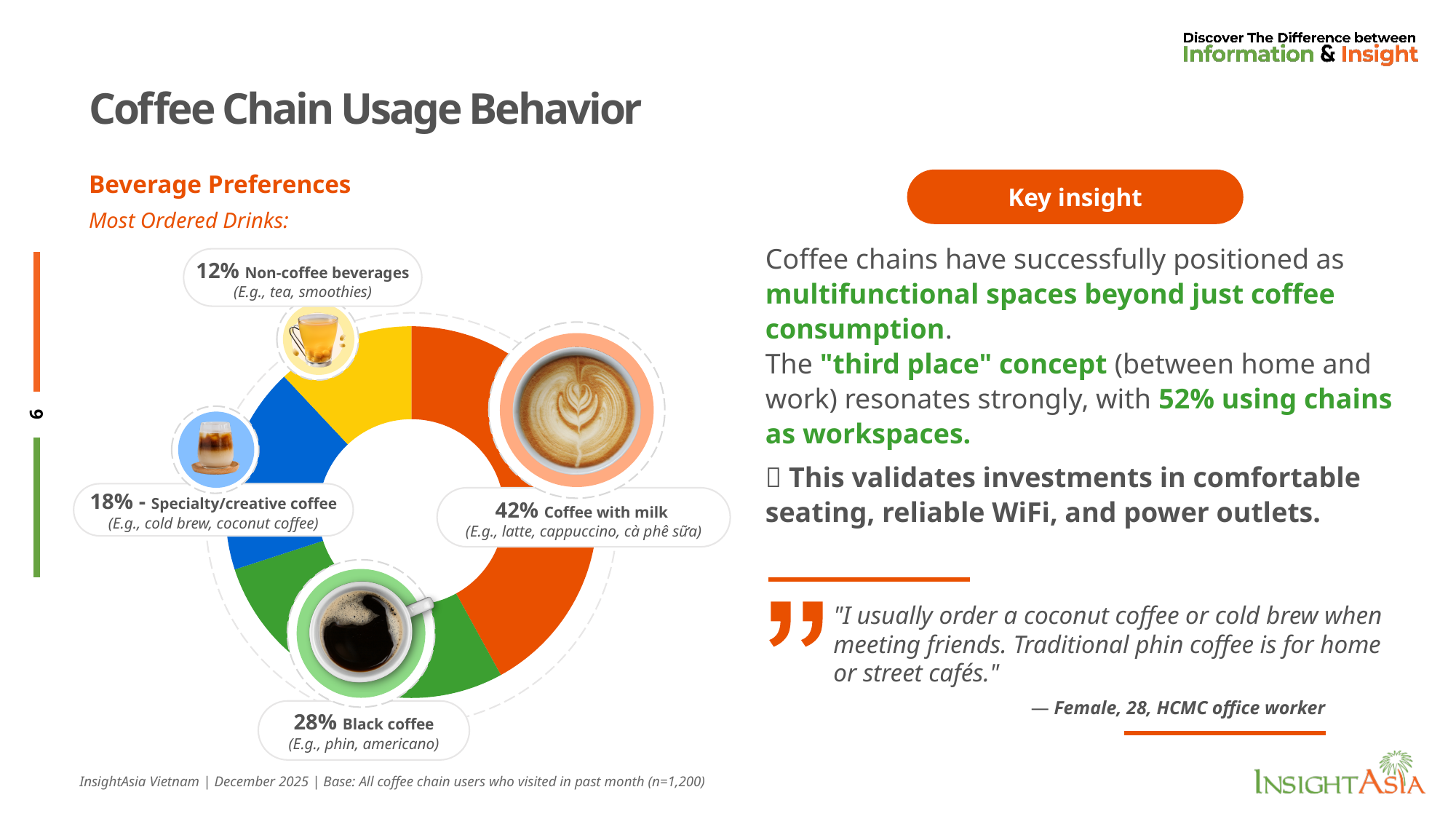
What is the difference in percentage points between Coffee with milk and Black coffee? 14 What colour is the Black coffee segment of the chart? Green What share of most ordered drinks is Non-coffee beverages? 12% What kind of chart is used to show the most ordered drinks? Donut (pie) chart Which drink category has the largest share in the chart? Coffee with milk What share of most ordered drinks is Black coffee? 28% What is the difference in percentage points between Specialty/creative coffee and Non-coffee beverages? 6 What share of most ordered drinks is Coffee with milk? 42% What share of most ordered drinks is Specialty/creative coffee? 18% Which has a larger share, Black coffee or Specialty/creative coffee? Black coffee Which drink category has the smallest share in the chart? Non-coffee beverages How many drink categories are shown in the chart? 4